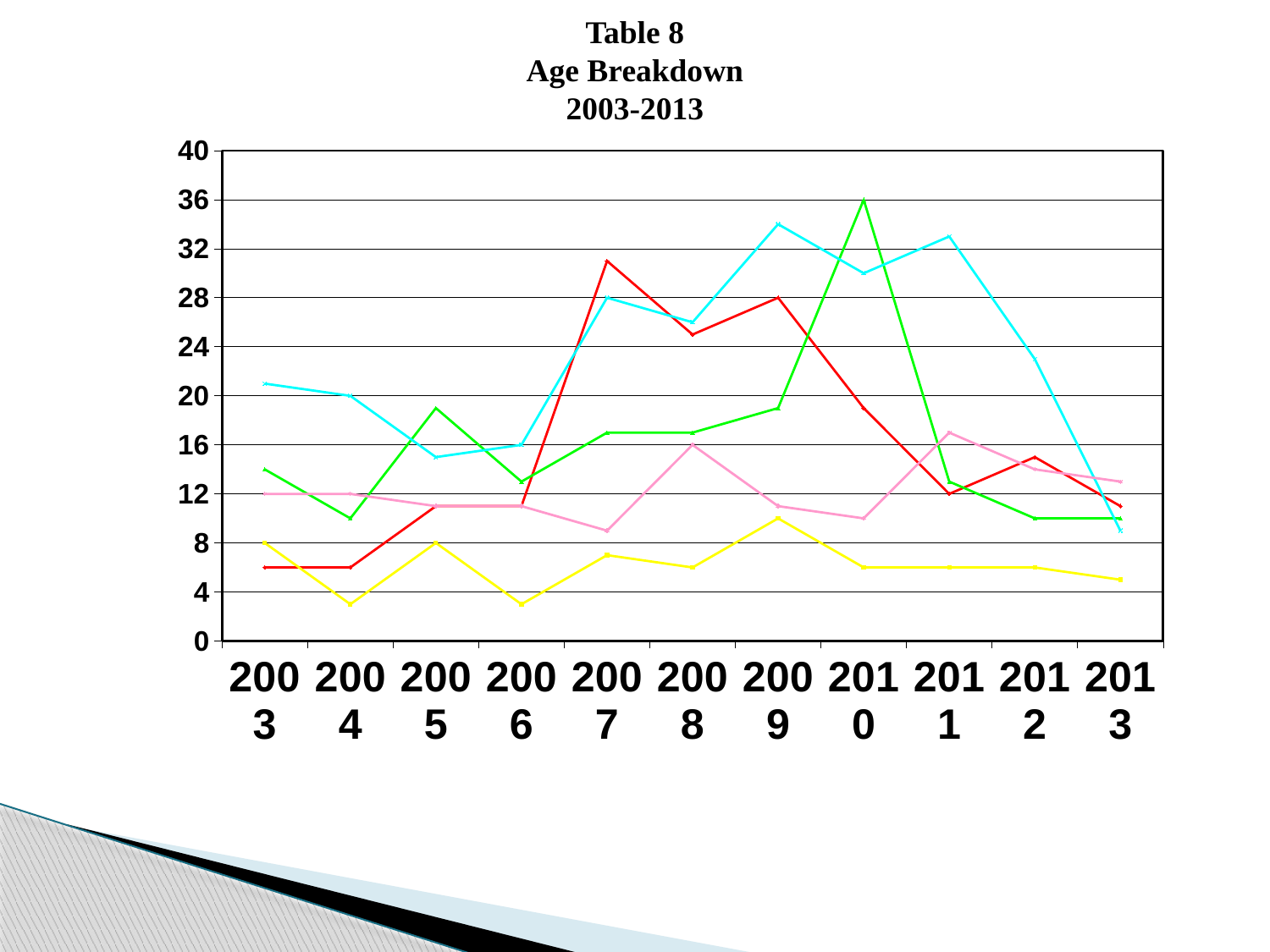
In which year does the green line reach its highest value? 2010 Does the cyan line rise or fall from 2011 to 2013? fall In 2013, which line has the lowest value? yellow line In 2010, which line is higher, the green line or the cyan line? green line In 2007, which line is higher, the red line or the cyan line? red line What is the title of the chart? Table 8 Age Breakdown 2003-2013 How many years are plotted along the x axis? 11 Is the value of the green line in 2010 greater or less than 32? greater What kind of chart is shown on the slide? line chart Is the value of the cyan line in 2009 greater or less than 32? greater Is the value of the pink line in 2008 greater or less than 12? greater